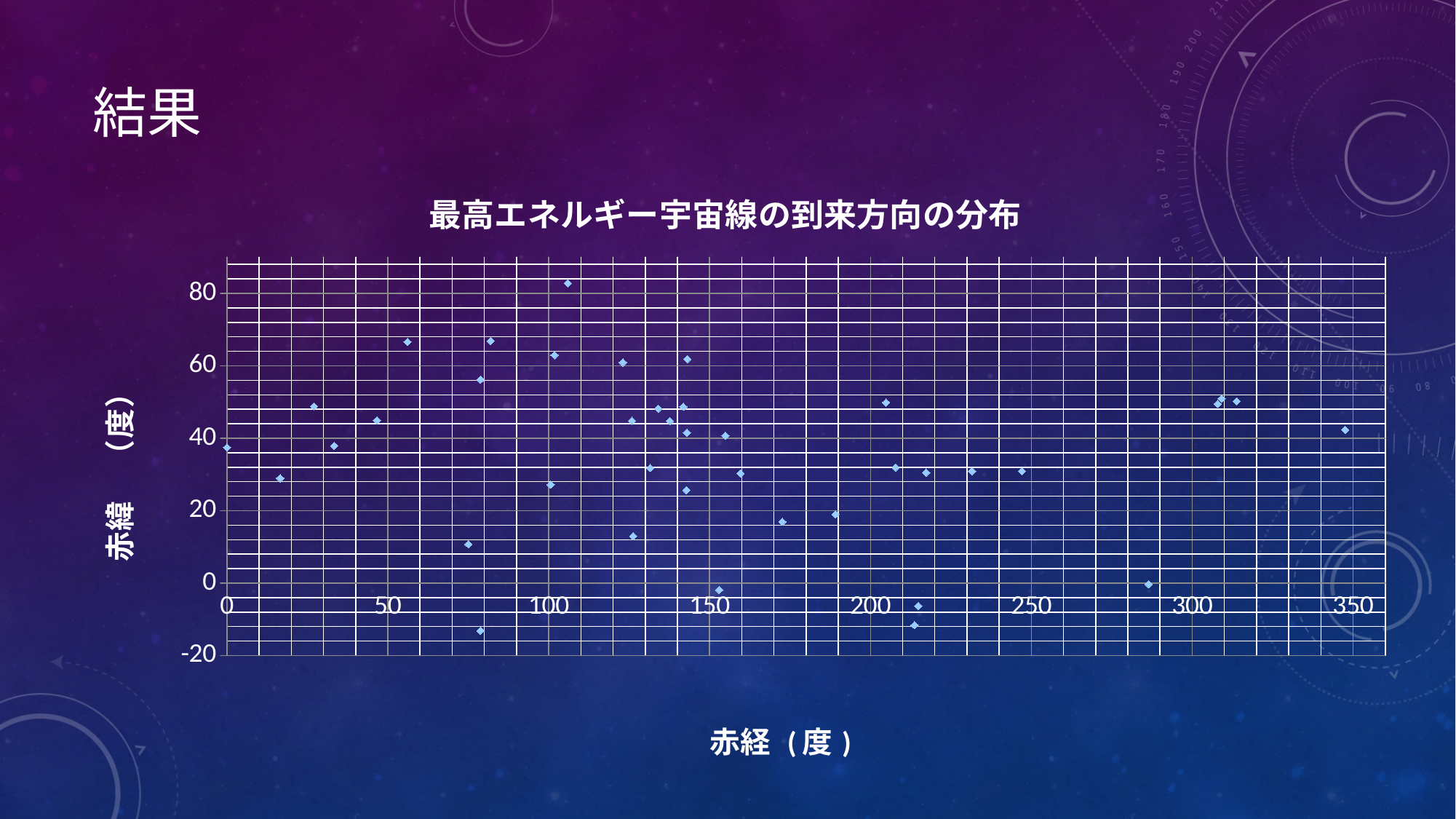
What is the label of the horizontal axis of the chart? 赤経（度） Is the 赤経 of the rightmost point in the chart greater or less than 350? less What is the highest value printed on the horizontal axis of the chart? 350 Is the 赤緯 of the highest point in the chart greater or less than 60? greater What is the highest value printed on the vertical axis of the chart? 80 Is the 赤緯 of the lowest point in the chart greater or less than 0? less What kind of chart is shown on the slide? scatter chart What is the title of the chart? 最高エネルギー宇宙線の到来方向の分布 What is the lowest value printed on the vertical axis of the chart? -20